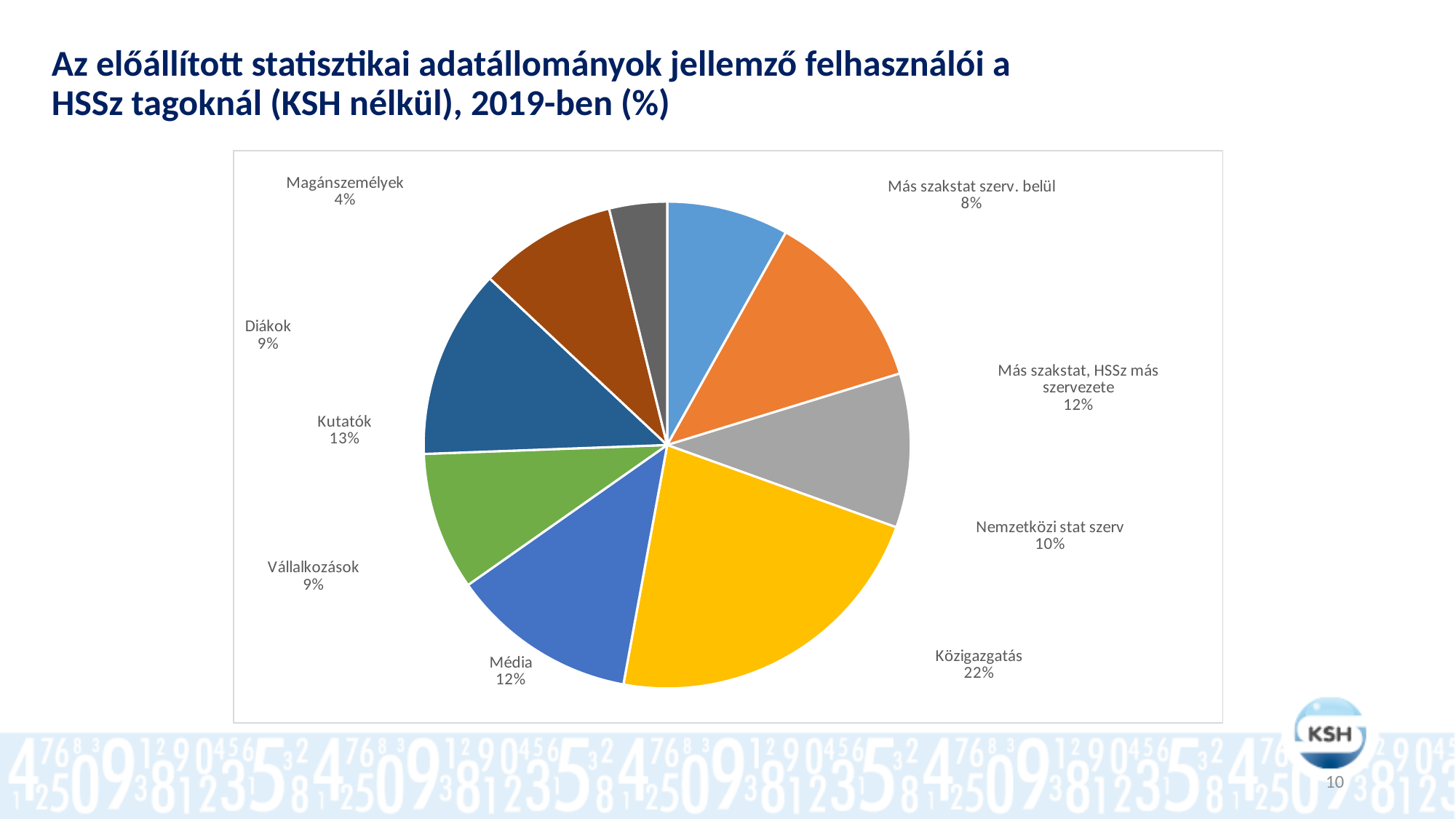
Which category has the smallest slice of the pie? Magánszemélyek What is the value shown for Magánszemélyek? 4% What is the value shown for Kutatók? 13% How many slices does the pie chart have? 9 What is the difference between the shares of Közigazgatás and Kutatók? 9 percentage points Which is larger, the share of Média or the share of Más szakstat szerv. belül? Média What kind of chart is shown on the slide? pie chart Which category has the largest slice of the pie? Közigazgatás What is the value shown for Nemzetközi stat szerv? 10% What share of the pie does Közigazgatás have? 22% What year does the chart title refer to? 2019 What is the combined share of Diákok and Vállalkozások? 18%